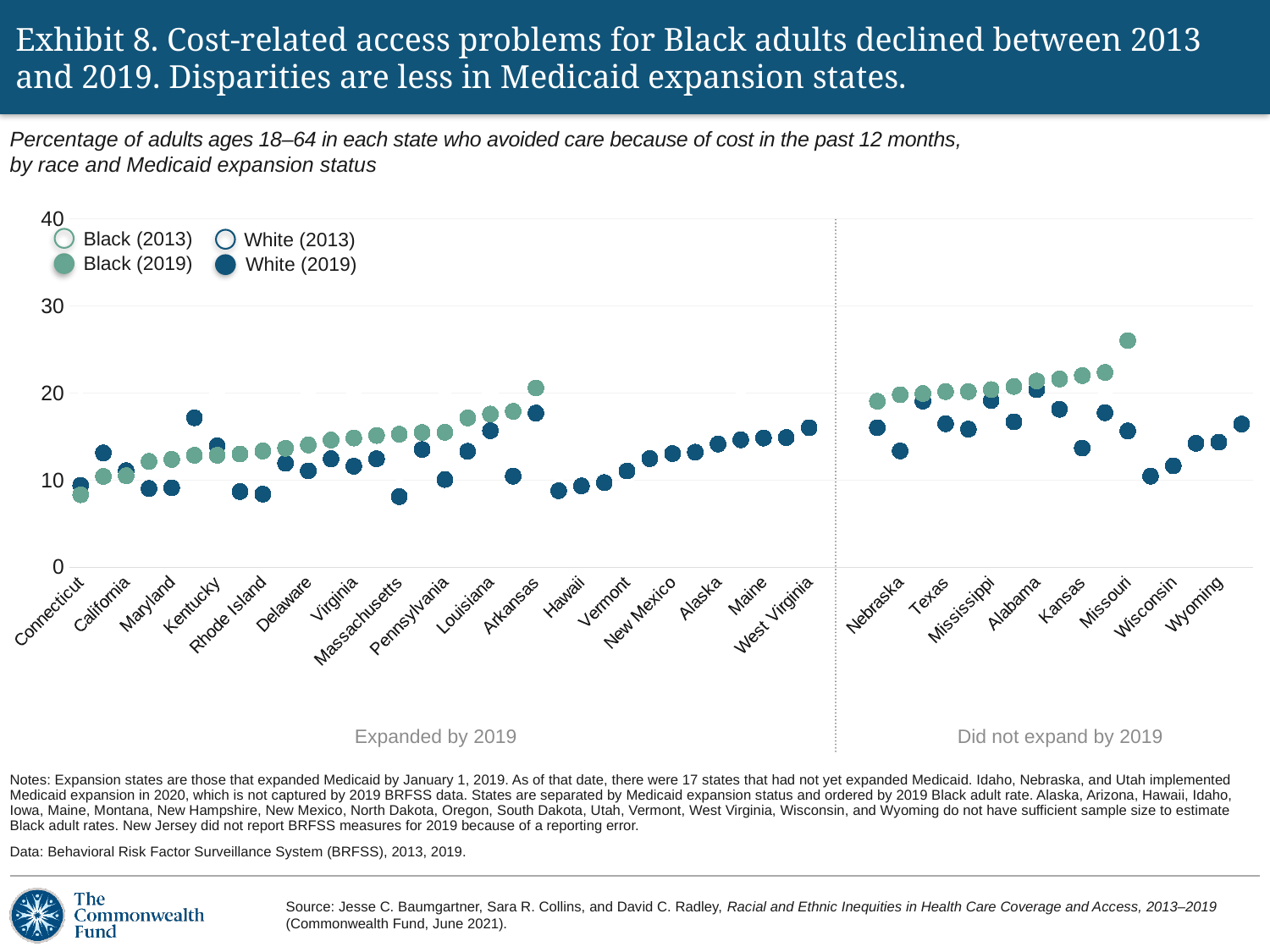
Is the White (2019) value for Kentucky greater or less than 10? greater Is the Black (2019) value for Kansas greater or less than 20? greater Which series are listed in the chart legend? Black (2013), White (2013), Black (2019), White (2019) Which is larger, the Black (2019) value for Missouri or the Black (2019) value for Connecticut? Missouri Is the White (2019) value for Massachusetts greater or less than 10? less What are the two group labels shown beneath the x axis? Expanded by 2019; Did not expand by 2019 How many series does the chart legend list? 4 What kind of chart is shown on the slide? Scatter (dot) chart Within the 'Expanded by 2019' group, do the Black (2019) values generally rise or fall from left to right along the x axis? rise Which state has the highest Black (2019) value on the chart? Missouri